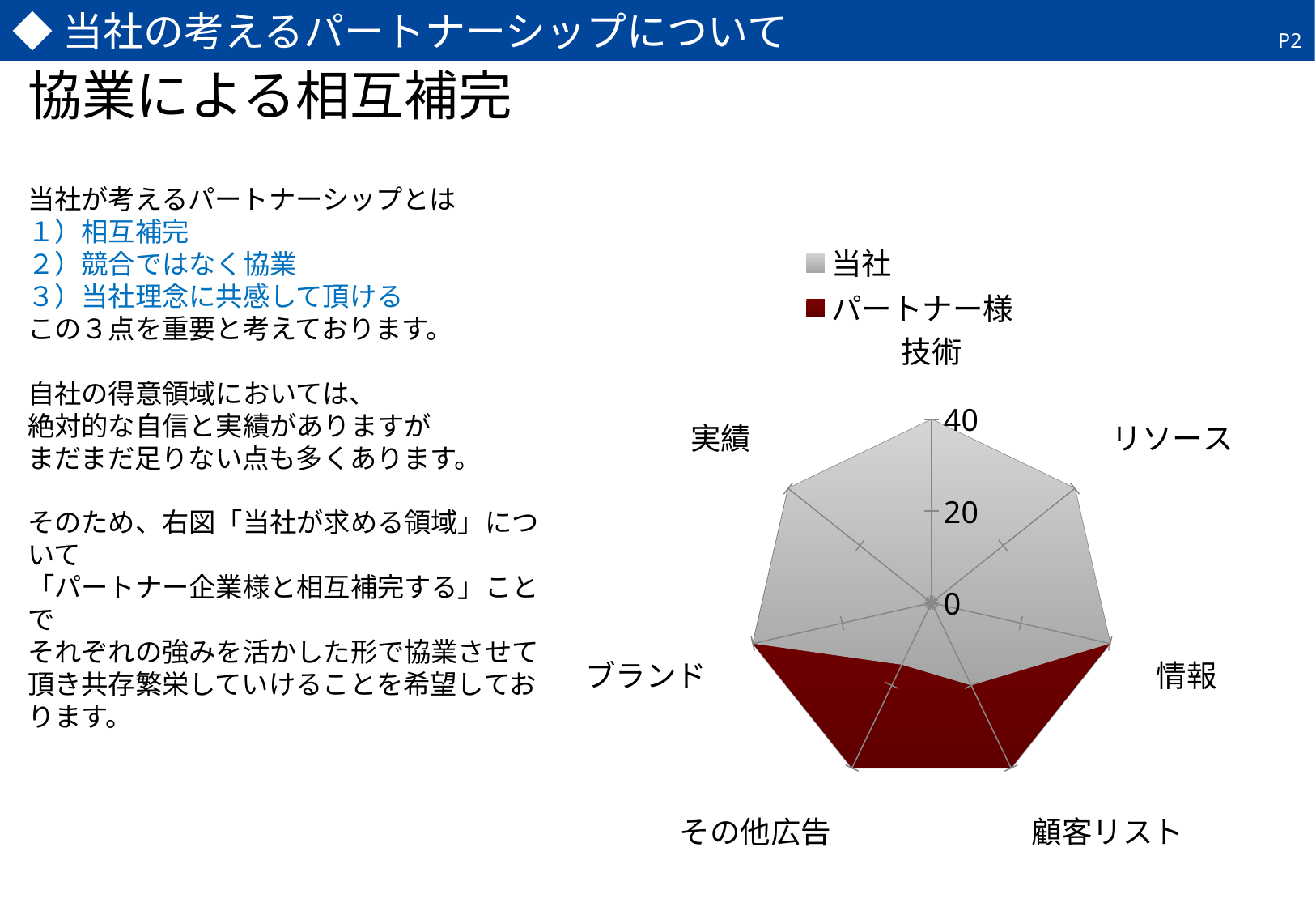
What is the maximum value shown on the radar chart's axis? 40 How many categories (axes) does the radar chart have? 7 For その他広告, which series has the larger value, 当社 or パートナー様? パートナー様 Is the value of 当社 for 顧客リスト greater or less than 40? less Is the value of 当社 for 技術 greater or less than 20? greater How many series does the legend of the radar chart list? 2 For 技術, which series has the larger value, 当社 or パートナー様? 当社 Is the value of パートナー様 for 顧客リスト greater or less than 20? greater What are the two series named in the legend of the radar chart? 当社 and パートナー様 What kind of chart is shown on the slide? Radar chart